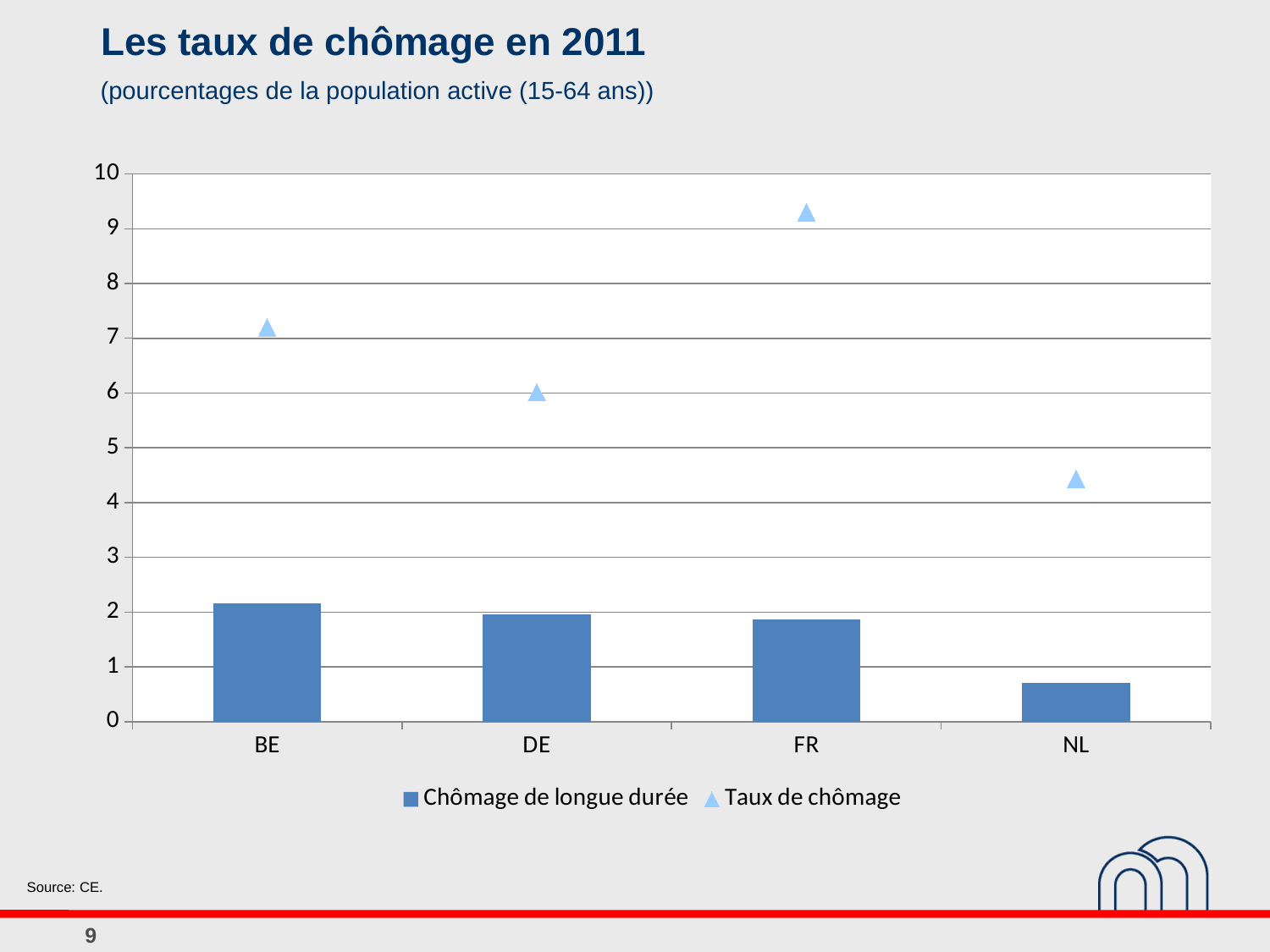
Which country has the highest Taux de chômage in the chart? FR Which country has the highest Chômage de longue durée bar? BE Which is larger, the Chômage de longue durée for BE or for NL? BE Is the Chômage de longue durée for NL greater or less than 1? less What is the title of the chart on the slide? Les taux de chômage en 2011 Which country has the lowest Chômage de longue durée bar? NL Is the Taux de chômage for NL greater or less than 5? less Is the Taux de chômage for BE greater or less than 7? greater How many series does the chart legend list? 2 Which country has the lowest Taux de chômage in the chart? NL How many countries are shown on the x axis of the chart? 4